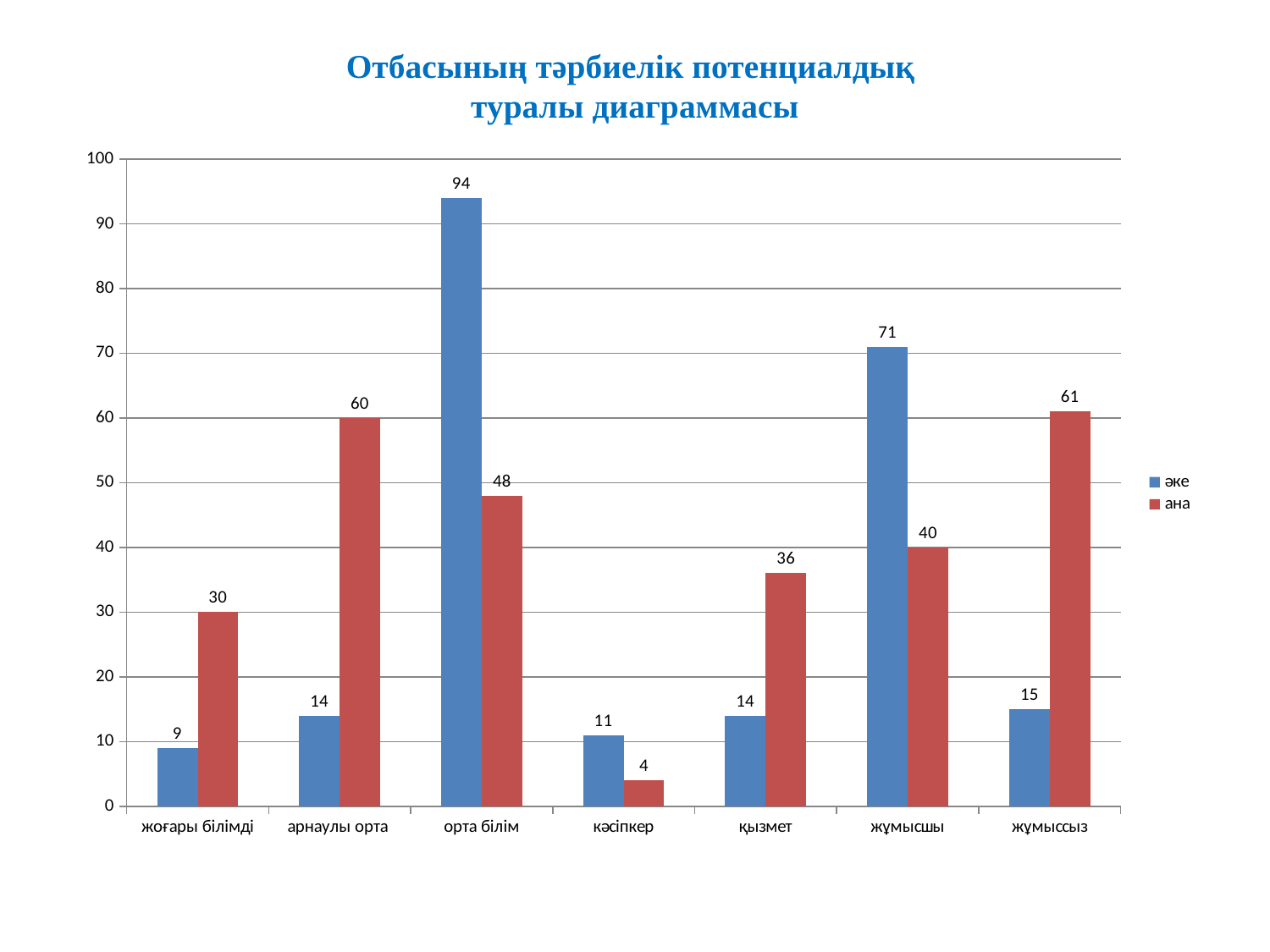
Is the value for ана in the қызмет category greater or less than 30? greater How many categories are shown on the x axis? 7 What is the value for әке in the жоғары білімді category? 9 What is the value for ана in the жұмыссыз category? 61 Which category has the highest value for әке? орта білім What is the difference between the әке and ана values in the жұмысшы category? 31 How many series does the legend list? 2 What kind of chart is shown on the slide? bar chart What colour are the bars for the ана series? red Which category has the lowest value for ана? кәсіпкер What is the value for әке in the орта білім category? 94 In the арнаулы орта category, which series has the larger value, әке or ана? ана